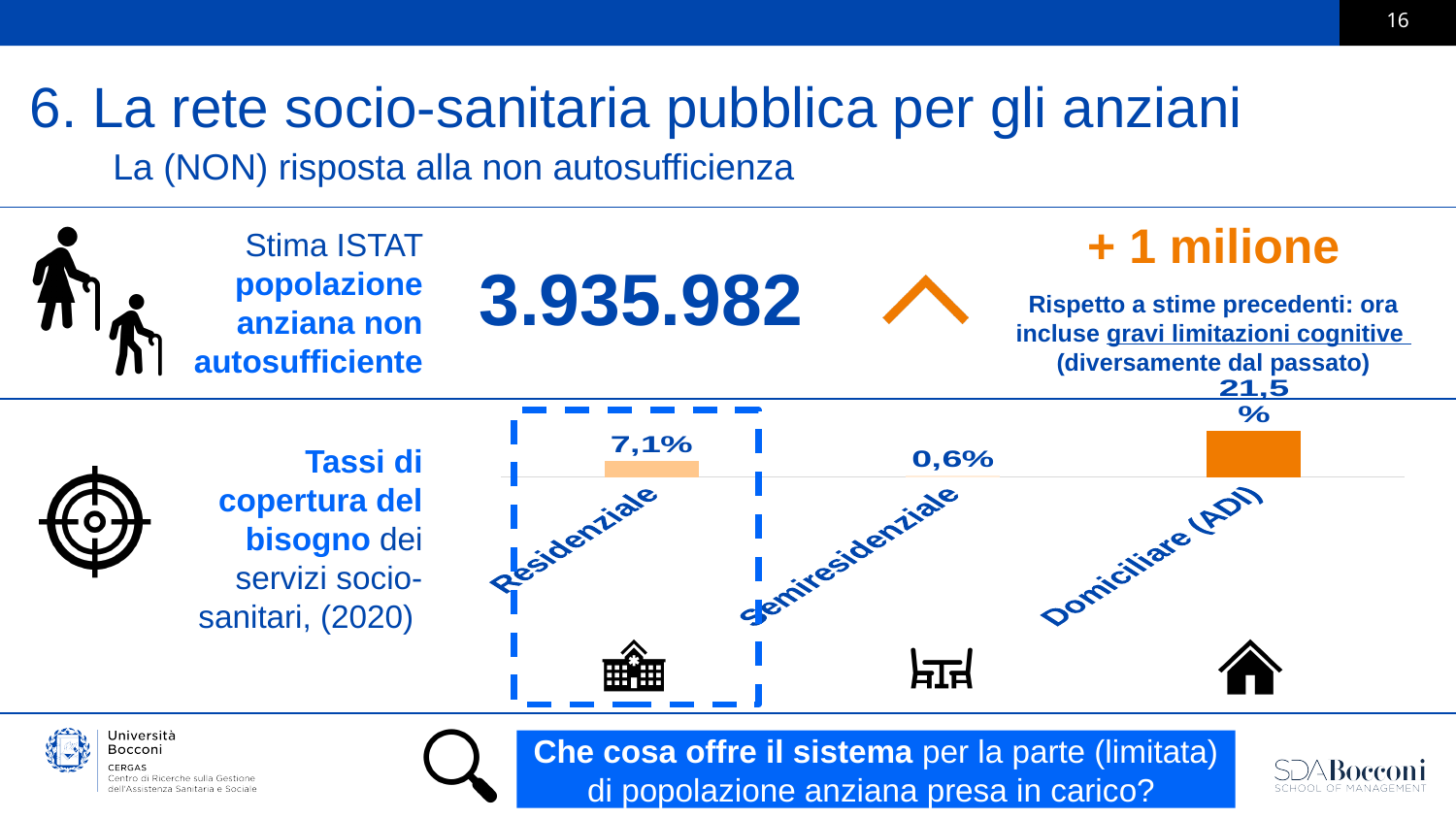
Which category has the lowest coverage rate in the chart? Semiresidenziale What is the difference between the coverage rates for Domiciliare (ADI) and Residenziale? 14,4% What is the coverage rate shown for Residenziale? 7,1% What is the difference between the coverage rates for Residenziale and Semiresidenziale? 6,5% How many categories are shown in the chart? 3 What is the coverage rate shown for Semiresidenziale? 0,6% Which is larger, the coverage rate for Residenziale or for Semiresidenziale? Residenziale Which category has the highest coverage rate in the chart? Domiciliare (ADI) Which category in the chart is highlighted with a dashed blue box? Residenziale What year do the coverage rates in the chart refer to? 2020 What kind of chart is used to show the coverage rates? Bar chart What is the coverage rate shown for Domiciliare (ADI)? 21,5%